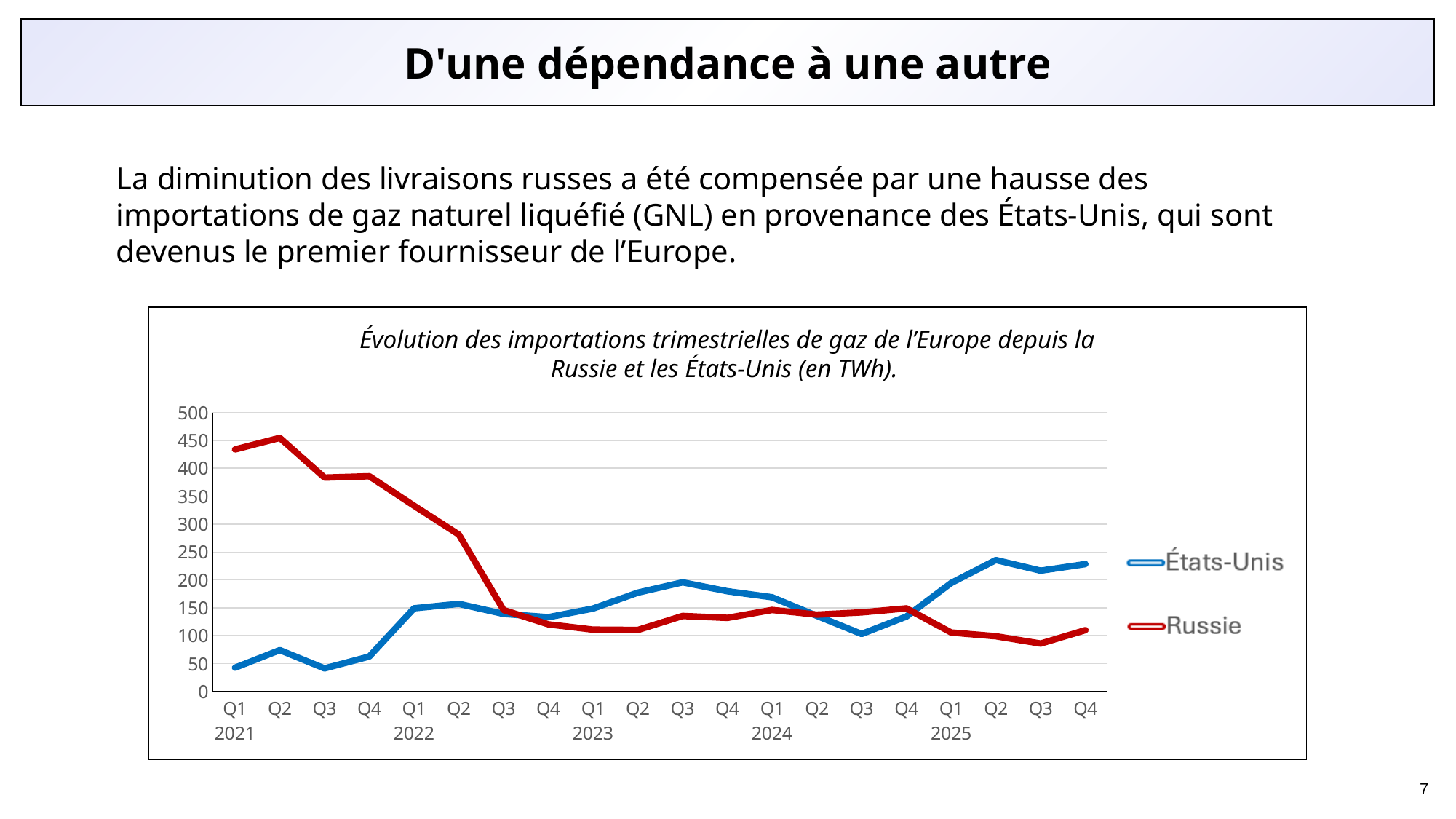
How many series does the chart legend list? 2 In Q2 2025, which series has the larger value, États-Unis or Russie? États-Unis How many quarterly points are plotted along the x axis for each series? 20 What kind of chart is shown on the slide? line chart Is the value for Russie in Q1 2022 greater or less than 300? greater Is the value for États-Unis in Q3 2023 greater or less than 150? greater Is the value for Russie in Q1 2021 greater or less than 400? greater In Q1 2021, which series has the larger value, États-Unis or Russie? Russie In which quarter does the Russie series reach its highest value? Q2 2021 Does the Russie series generally rise or fall from Q1 2021 to Q4 2025? fall In which quarter does the Russie series reach its lowest value? Q3 2025